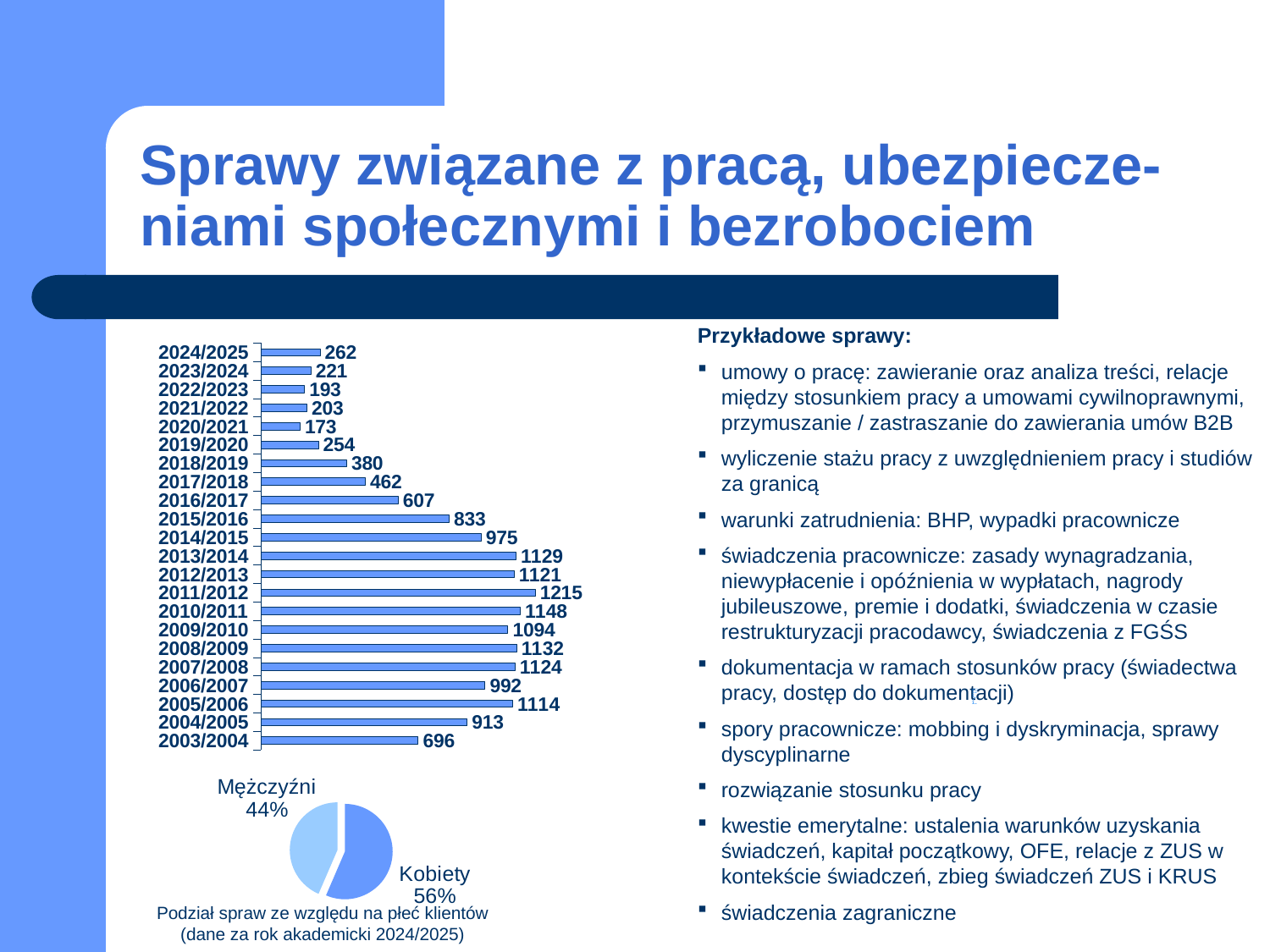
What kind of chart is the chart at the bottom left of the slide titled 'Podział spraw ze względu na płeć klientów'? Pie chart In the bar chart on the left of the slide, what is the difference between the values for 2011/2012 and 2020/2021? 1042 In the bar chart on the left of the slide, which is larger: the value for 2016/2017 or the value for 2017/2018? 2016/2017 What kind of chart is the chart on the left of the slide showing values by academic year? Bar chart In the bar chart on the left of the slide, what is the value for 2024/2025? 262 How many academic years are shown in the bar chart on the left of the slide? 22 In the bar chart on the left of the slide, which academic year has the highest value? 2011/2012 In the bar chart on the left of the slide, which academic year has the lowest value? 2020/2021 In the pie chart at the bottom left of the slide, what share is Mężczyźni? 44% In the pie chart at the bottom left of the slide, what share is Kobiety? 56% In the bar chart on the left of the slide, do the values rise or fall from 2013/2014 to 2020/2021? Fall In the bar chart on the left of the slide, what is the value for 2003/2004? 696